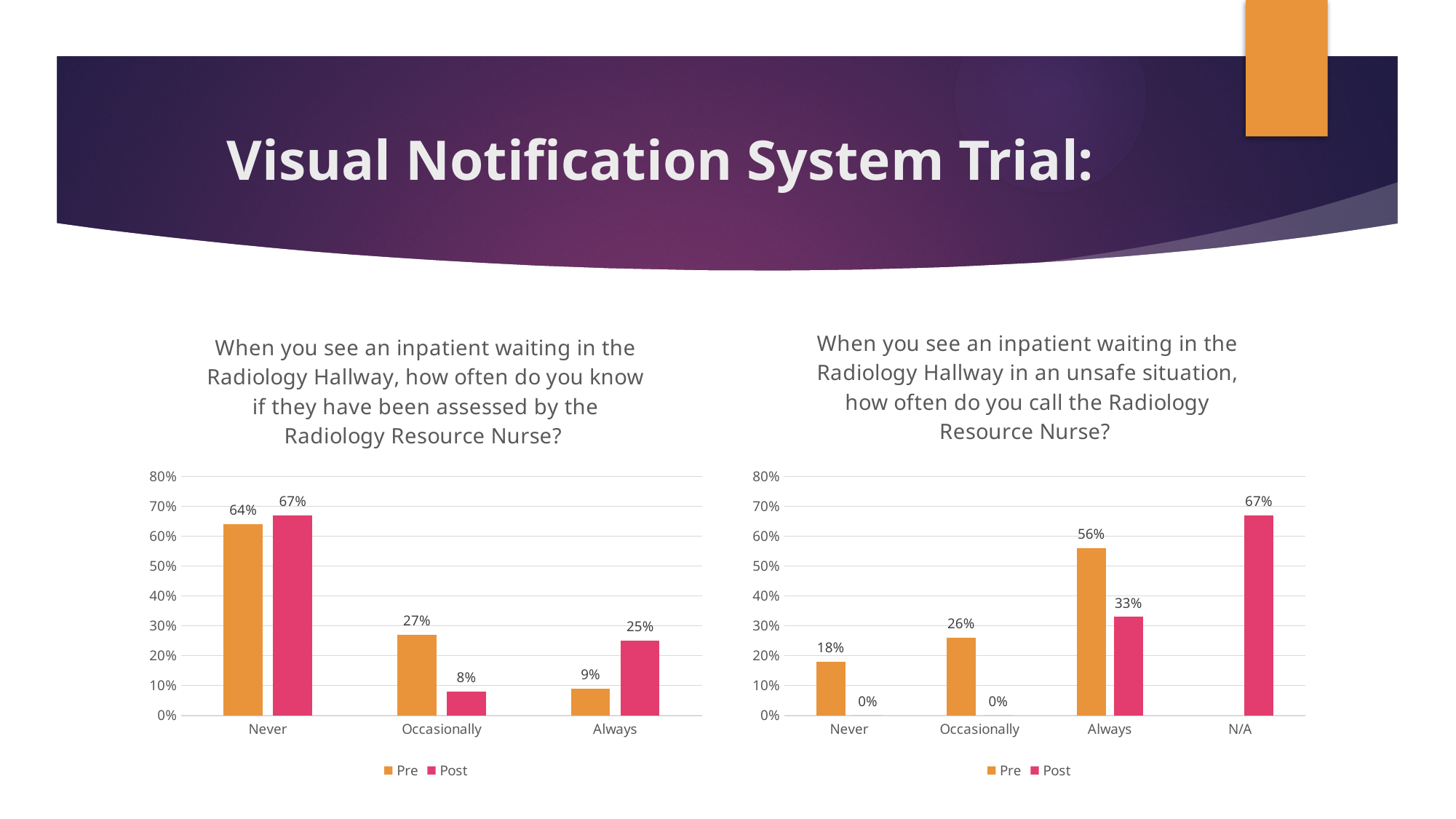
In the left chart, how many categories are shown on the x axis? 3 In the left chart, is the Pre value for Occasionally larger or smaller than the Post value for Occasionally? larger In the left chart, which category has the highest Post value? Never In the left chart, what is the Post value for Occasionally? 8% In the left chart, what is the Pre value for Never? 64% In the right chart, what is the Pre value for Always? 56% In the right chart, which category has the lowest Pre value? Never In the right chart, what is the difference between the Pre and Post values for Always? 23% In the left chart, what is the difference between the Pre and Post values for Always? 16% In the right chart, what is the Post value for N/A? 67% In the right chart, how many series does the legend list? 2 What type of chart is the right chart? Bar chart